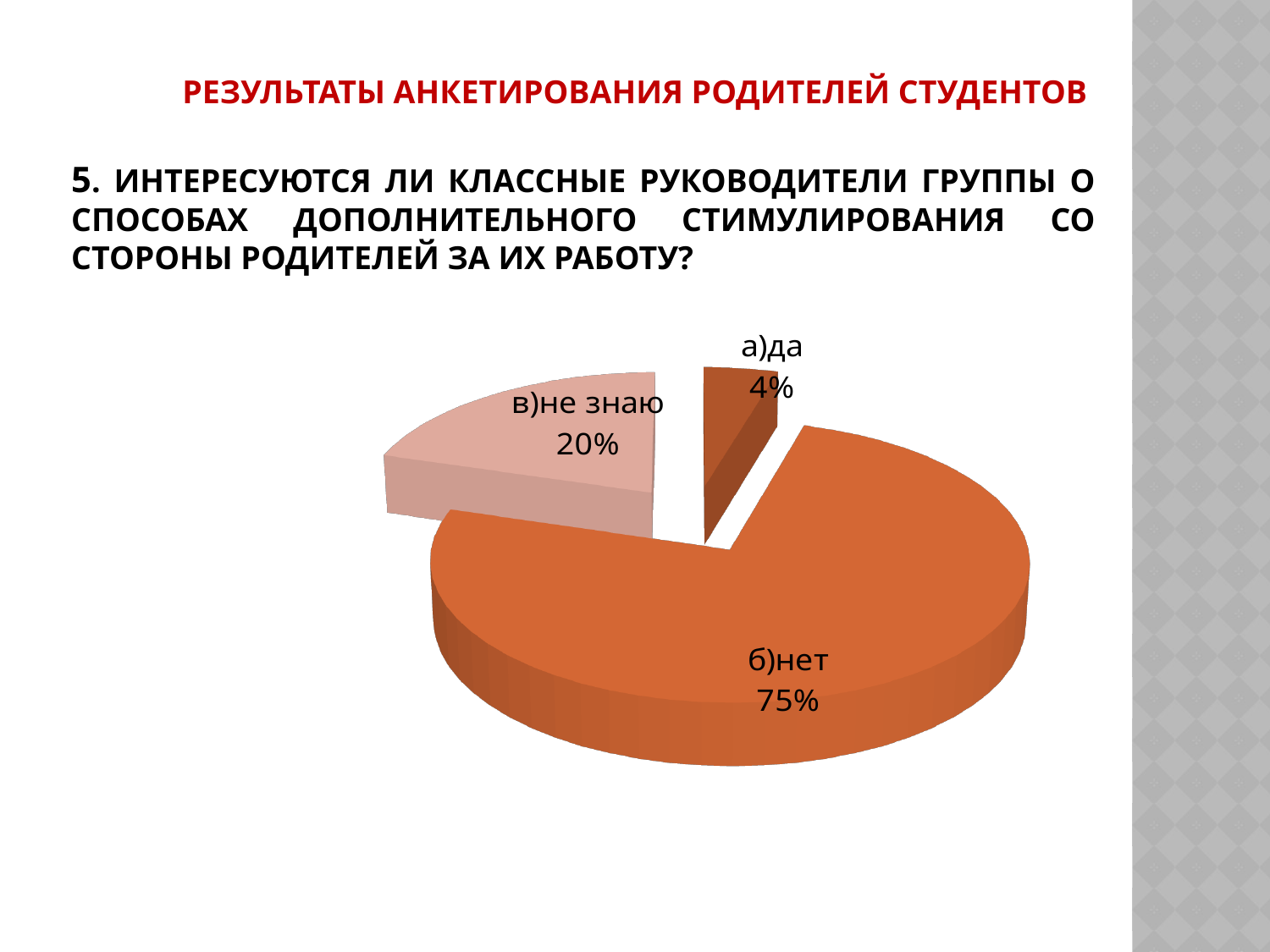
Is the share for "б)нет" greater or less than 50%? greater What is the difference in percentage points between "в)не знаю" and "а)да"? 16 What kind of chart is shown on the slide? pie chart Which slice of the pie is the smallest? а)да Which slice of the pie is the largest? б)нет How many slices does the pie chart have? 3 Which slice of the pie is shown in the lightest colour? в)не знаю What share of the pie does "в)не знаю" have? 20% Which is larger, the share for "в)не знаю" or the share for "а)да"? в)не знаю What share of the pie does "а)да" have? 4% What is the difference in percentage points between "б)нет" and "в)не знаю"? 55 What share of the pie does "б)нет" have? 75%